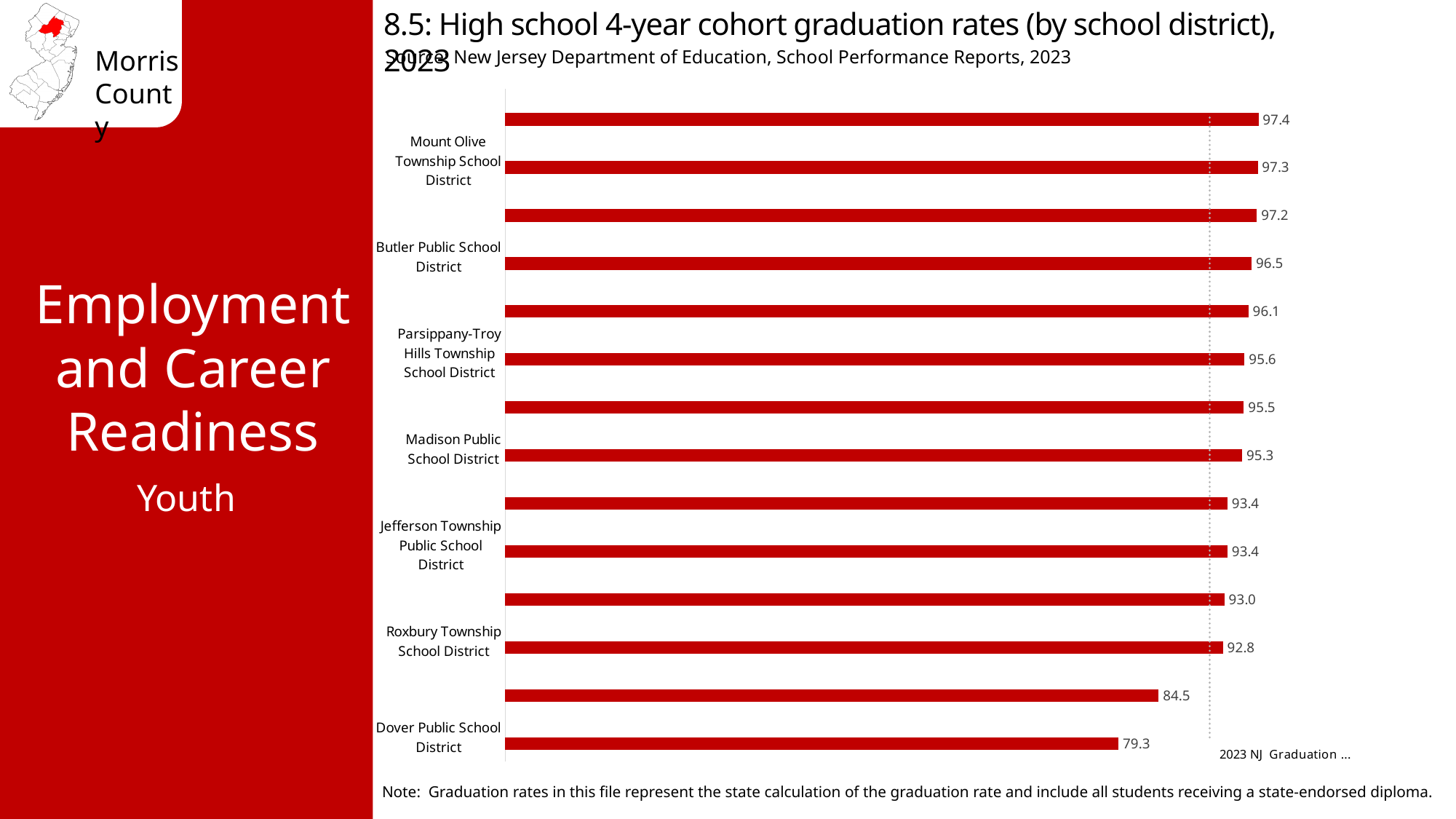
What is the graduation rate shown for Dover Public School District? 79.3 Which labeled school district has the lowest graduation rate on the chart? Dover Public School District Do the graduation rates increase or decrease going from the top bar to the bottom bar? Decrease What is the difference between the graduation rates of Mount Olive Township School District and Dover Public School District? 18.0 What is the graduation rate for Parsippany-Troy Hills Township School District? 95.6 Which has a higher graduation rate, Madison Public School District or Jefferson Township Public School District? Madison Public School District What is the difference between the graduation rates of Butler Public School District and Roxbury Township School District? 3.7 What type of chart is shown on the slide? Bar chart What is the graduation rate for Butler Public School District? 96.5 What is the graduation rate for Roxbury Township School District? 92.8 How many bars are plotted on the chart? 14 What is the 4-year cohort graduation rate for Mount Olive Township School District? 97.3